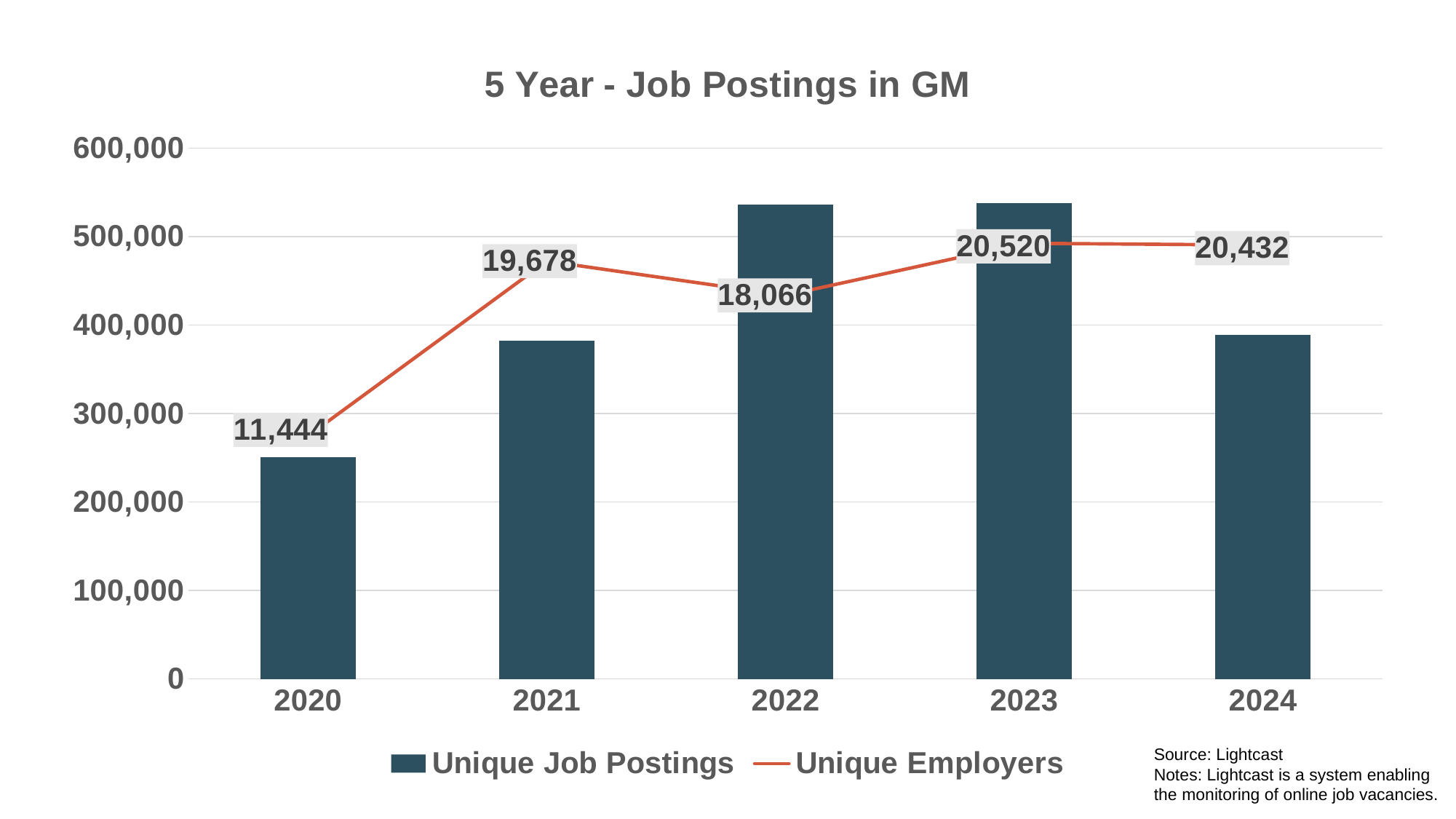
What is the difference between the Unique Employers values for 2021 and 2020? 8,234 Which year has the highest value for Unique Employers? 2023 What is the value for Unique Employers in 2023? 20,520 Which year has the lowest value for Unique Job Postings? 2020 What is the value for Unique Employers in 2024? 20,432 What is the value for Unique Employers in 2020? 11,444 How many series does the legend list? 2 Is the value for Unique Job Postings in 2022 greater or less than 500,000? greater Is the value for Unique Job Postings in 2024 greater or less than 400,000? less Which is larger, the Unique Employers value for 2021 or for 2022? 2021 How many years are shown on the x axis? 5 Which year has the lowest value for Unique Employers? 2020